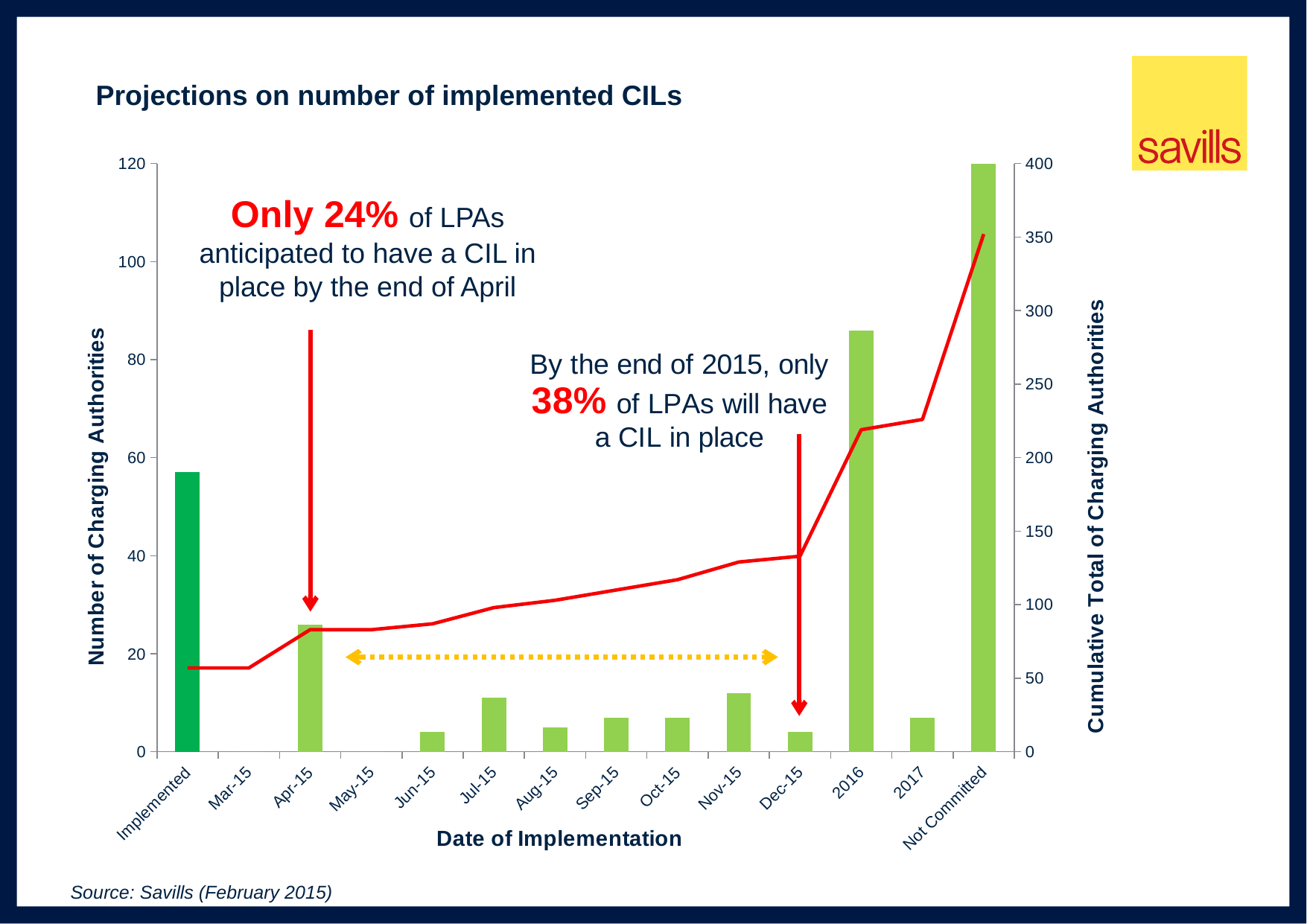
Which has the taller bar, Implemented or 2016? 2016 What is the title of the chart? Projections on number of implemented CILs Is the bar for Apr-15 greater or less than 40 charging authorities? less Which has the taller bar, Jun-15 or Jul-15? Jul-15 Is the bar for 2016 greater or less than 80 charging authorities? greater What kind of chart is shown on the slide? A combined bar and line chart Does the red cumulative line rise or fall from left to right across the x axis? Rises How many categories are shown on the x axis? 14 What is the label of the right-hand vertical axis? Cumulative Total of Charging Authorities Which category has the tallest bar? Not Committed Is the bar for Implemented greater or less than 40 charging authorities? greater